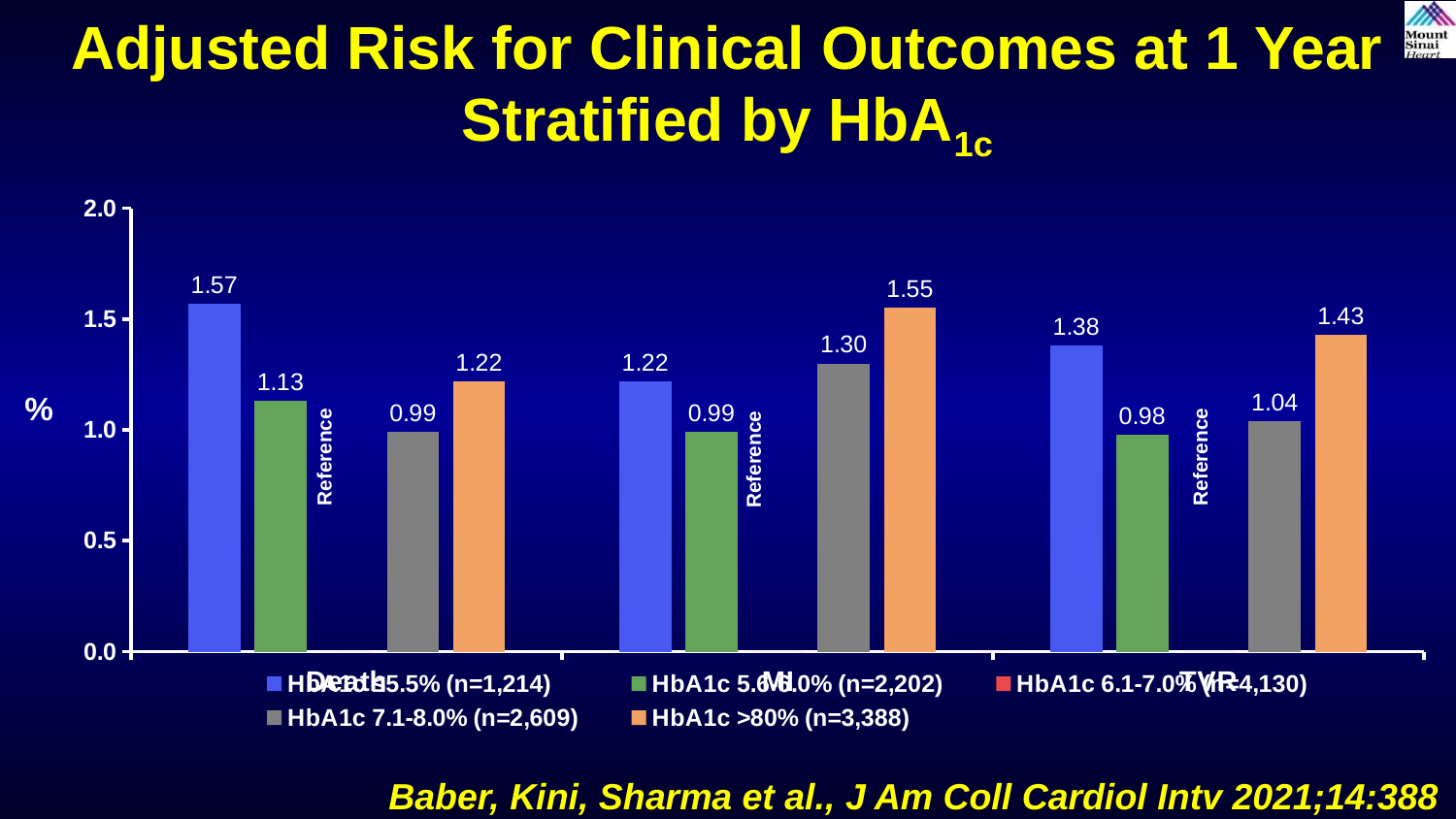
How many outcome categories are shown on the x axis? 3 What is the adjusted risk of MI for the HbA1c >80% (n=3,388) group? 1.55 Which HbA1c group has the lowest adjusted risk for TVR among the groups with a printed value? HbA1c 5.6-6.0% (n=2,202) What is the adjusted risk of MI for the HbA1c 5.6-6.0% (n=2,202) group? 0.99 How many HbA1c groups does the legend list? 5 What is the difference between the adjusted risk of Death for the HbA1c <5.5% group and the HbA1c 5.6-6.0% group? 0.44 What is the adjusted risk of TVR for the HbA1c 7.1-8.0% (n=2,609) group? 1.04 What is the adjusted risk of Death for the HbA1c <5.5% (n=1,214) group? 1.57 Which HbA1c group serves as the Reference group in the chart? HbA1c 6.1-7.0% (n=4,130) Which HbA1c group has the highest adjusted risk for Death? HbA1c ≤5.5% (n=1,214) What type of chart is shown on the slide? bar chart For MI, which group has the larger adjusted risk: HbA1c 7.1-8.0% or HbA1c >80%? HbA1c >80% (n=3,388)